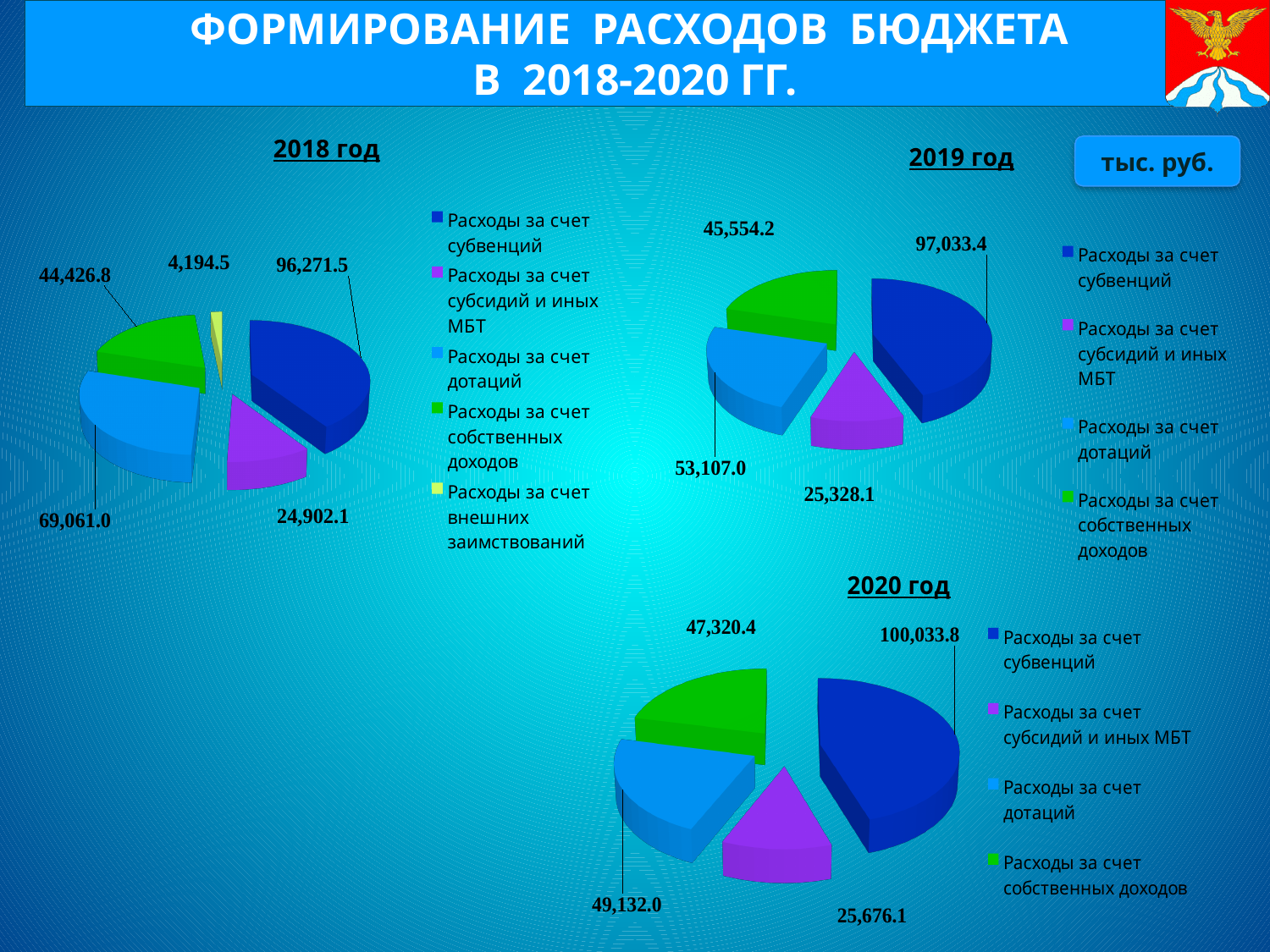
On the 2020 год chart, what is the value for Расходы за счет собственных доходов? 47,320.4 What kind of chart is the 2019 год chart? Pie chart On the 2018 год chart, what is the difference between Расходы за счет субвенций and Расходы за счет дотаций? 27,210.5 On the 2018 год chart, what is the value for Расходы за счет субвенций? 96,271.5 How many slices does the 2018 год chart have? 5 On the 2020 год chart, what is the difference between Расходы за счет субвенций and Расходы за счет субсидий и иных МБТ? 74,357.7 On the 2019 год chart, which is larger: Расходы за счет дотаций or Расходы за счет собственных доходов? Расходы за счет дотаций On the 2020 год chart, which category has the highest value? Расходы за счет субвенций On the 2018 год chart, which category has the lowest value? Расходы за счет внешних заимствований On the 2018 год chart, what is the value for Расходы за счет внешних заимствований? 4,194.5 On the 2019 год chart, what is the value for Расходы за счет дотаций? 53,107.0 On the 2019 год chart, which category has the lowest value? Расходы за счет субсидий и иных МБТ